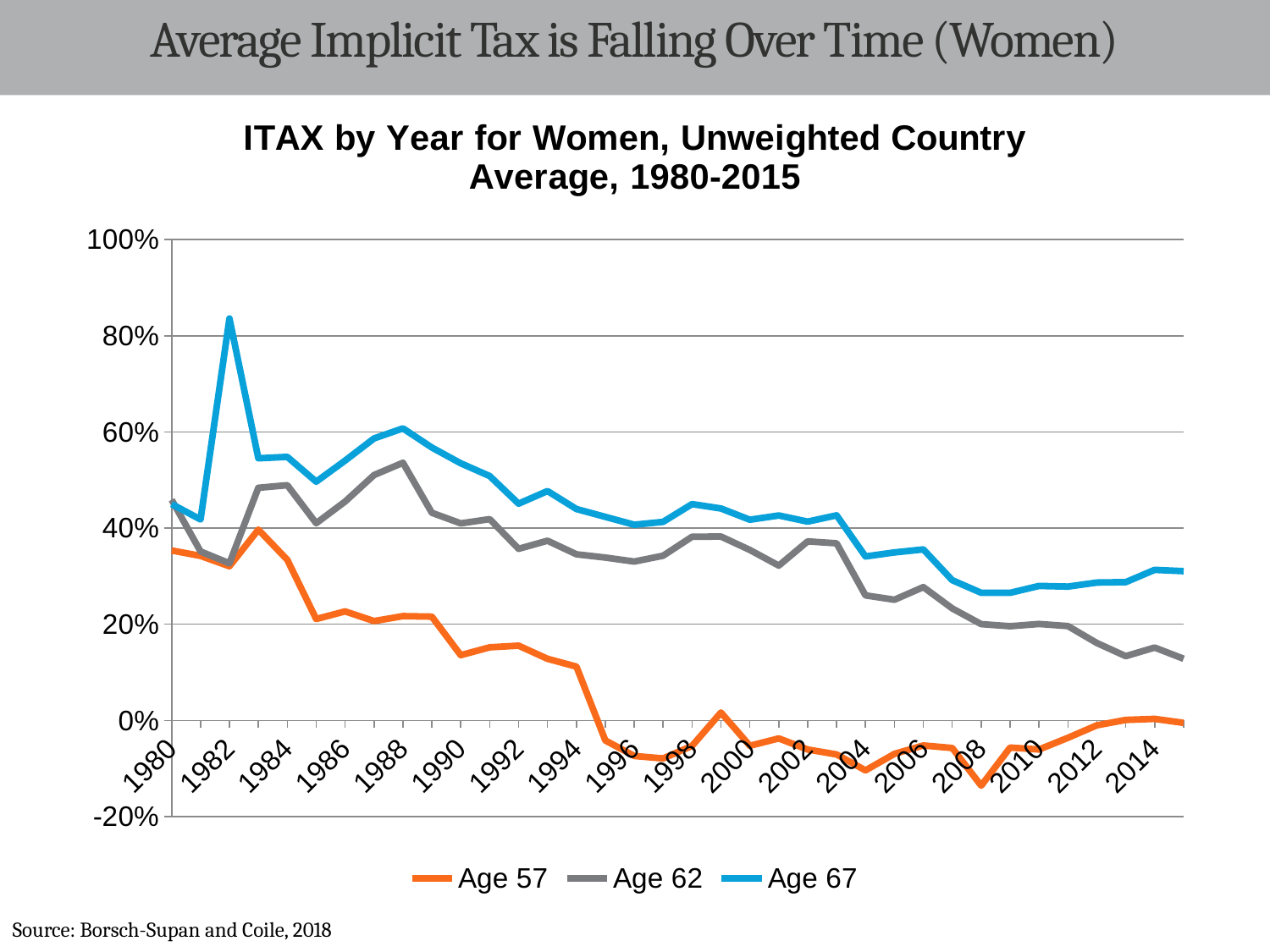
What is the title of the chart? ITAX by Year for Women, Unweighted Country Average, 1980-2015 In which year does the Age 67 series reach its peak? 1982 Is the value for Age 62 in 2014 greater or less than 20%? less What kind of chart is shown on the slide? line chart Overall, do the values for Age 57 rise or fall from 1980 to 2014? fall In 1990, which is larger, the value for Age 62 or the value for Age 57? Age 62 Is the value for Age 67 in 1982 greater or less than 60%? greater Which series has the lowest value in 2014? Age 57 Which series has the highest value in 2014? Age 67 Is the value for Age 57 in 2008 greater or less than 0%? less What are the three series named in the legend? Age 57, Age 62, Age 67 How many series does the legend list? 3